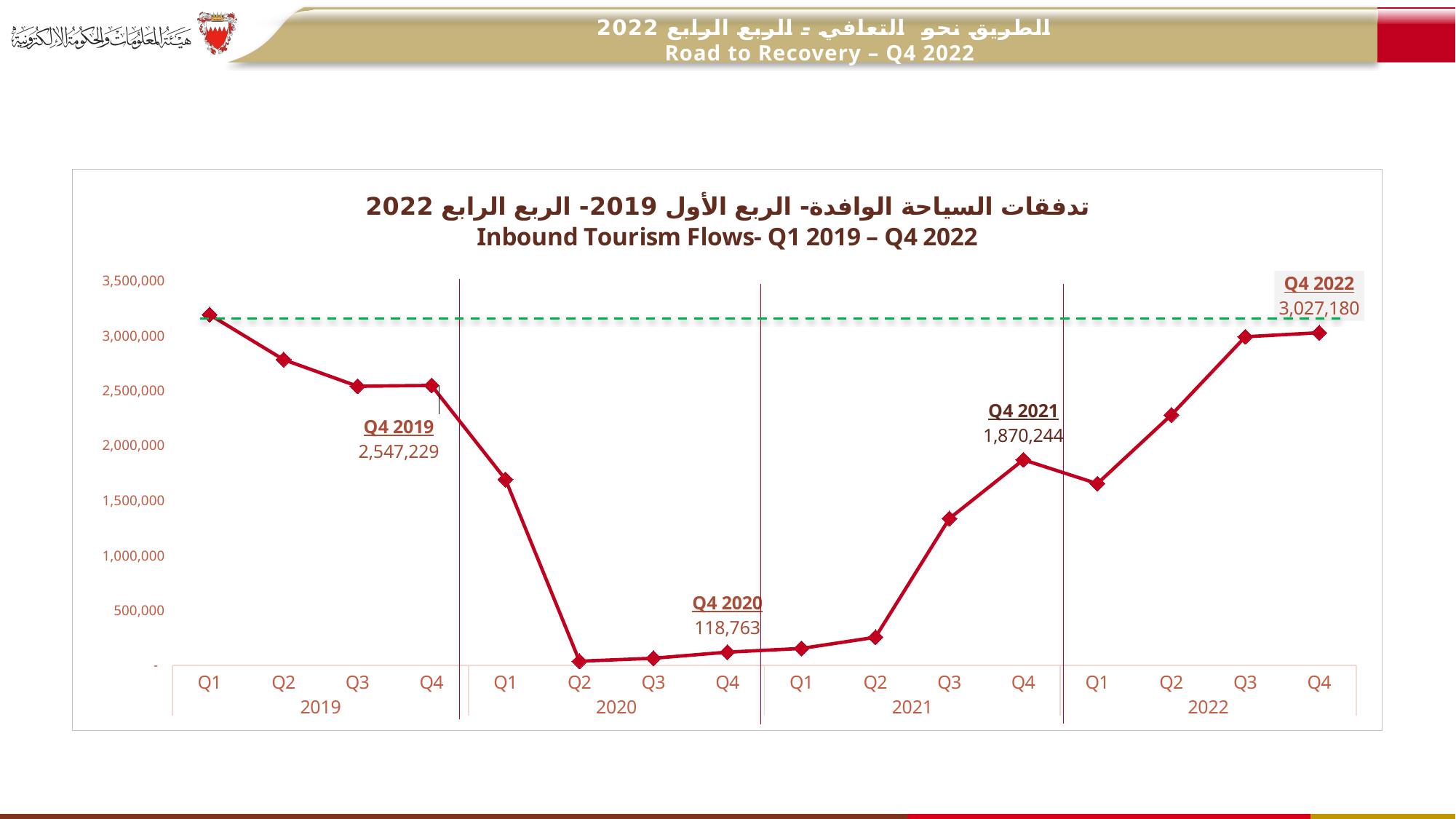
What is the value for Q4 2022 in the Inbound Tourism Flows chart? 3,027,180 What is the value for Q4 2020 in the Inbound Tourism Flows chart? 118,763 Is the value for Q2 2022 greater or less than 2,500,000? less What is the value for Q4 2021 in the Inbound Tourism Flows chart? 1,870,244 Do the values rise or fall across the four quarters of 2019? fall What kind of chart is used to show Inbound Tourism Flows Q1 2019 – Q4 2022? line chart What is the value for Q4 2019 in the Inbound Tourism Flows chart? 2,547,229 How many quarterly data points are plotted in the Inbound Tourism Flows chart? 16 What is the difference between the Q4 2022 value and the Q4 2021 value? 1,156,936 Among the four labelled Q4 values, which quarter has the highest value? Q4 2022 Among the four labelled Q4 values, which quarter has the lowest value? Q4 2020 Which is larger, the value for Q4 2019 or the value for Q4 2022? Q4 2022